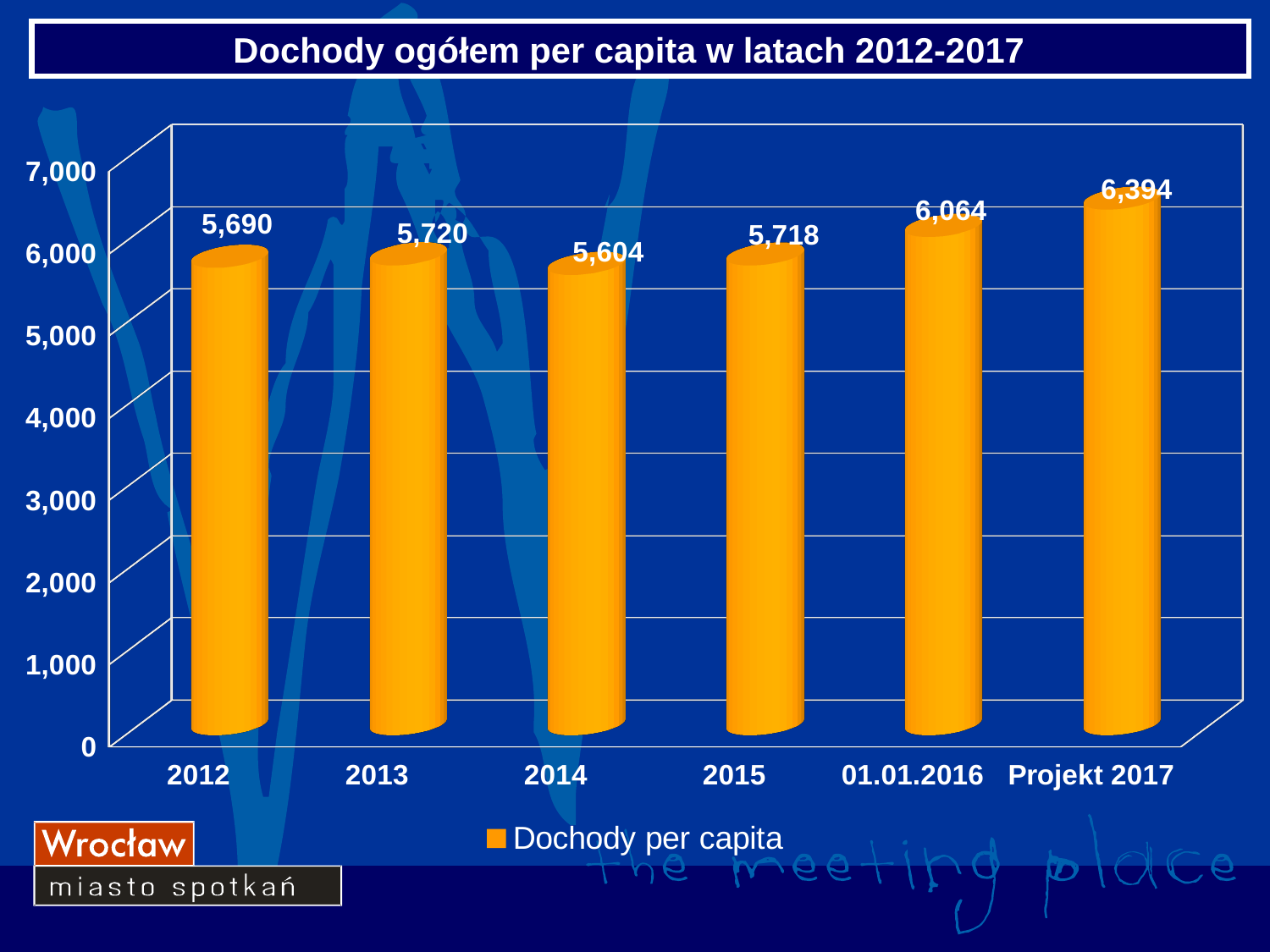
What is the value for 2014? 5,604 What is the value for Projekt 2017? 6,394 Which category has the highest value? Projekt 2017 What is the value for 01.01.2016? 6,064 What is the difference between the values for Projekt 2017 and 01.01.2016? 330 How many categories are shown on the x axis? 6 What is the value for 2012? 5,690 What kind of chart is shown? bar chart How many series does the legend list? 1 What is the title of the chart? Dochody ogółem per capita w latach 2012-2017 Which category has the lowest value? 2014 Which is larger, the value for 2013 or the value for 2015? 2013